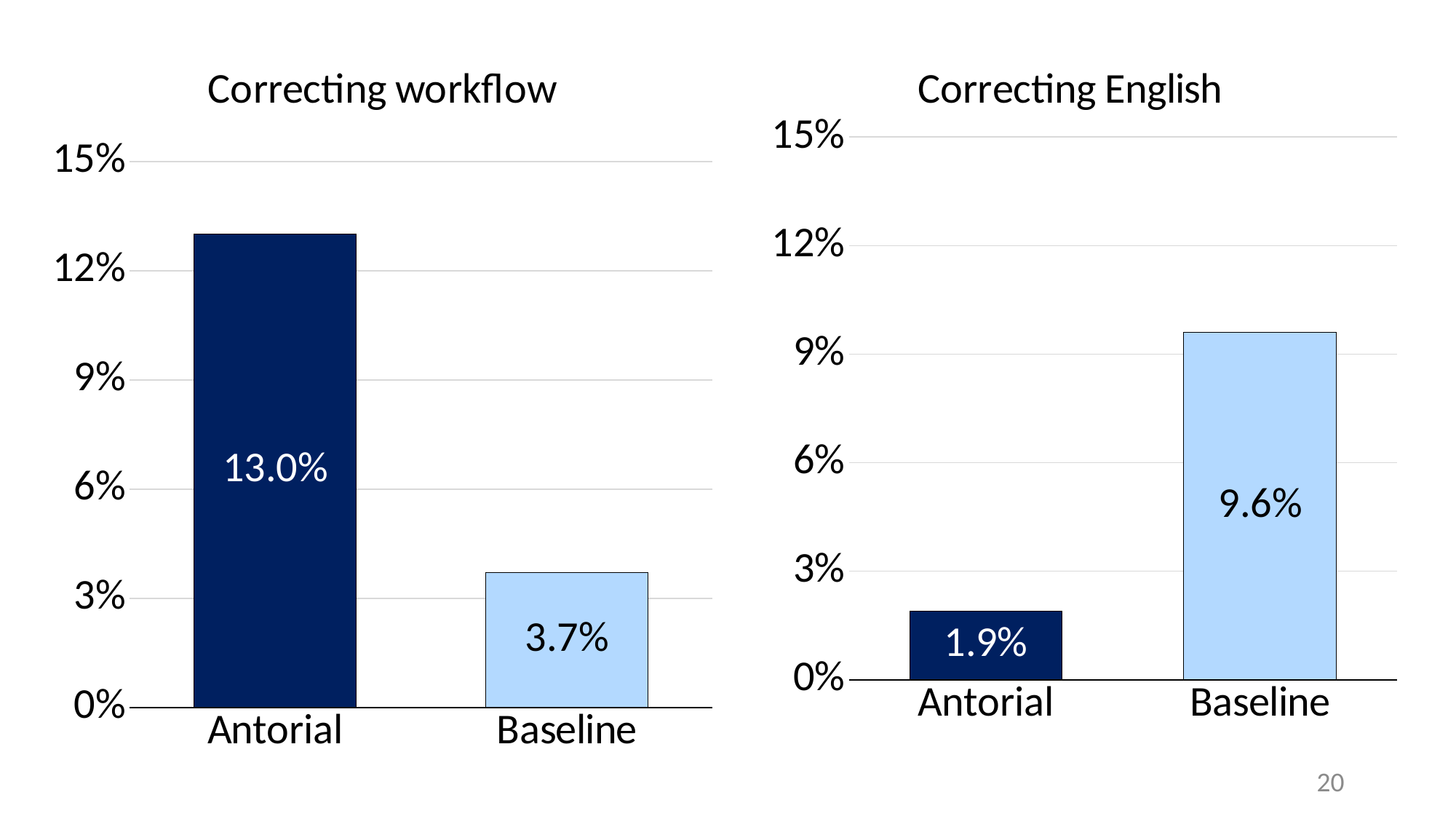
In the 'Correcting workflow' chart, what is the difference between the Antorial and Baseline values? 9.3% What type of chart is the 'Correcting workflow' chart? Bar chart How many categories are shown in the 'Correcting English' chart? 2 In the 'Correcting workflow' chart, what is the value for Baseline? 3.7% In the 'Correcting workflow' chart, is the value for Antorial greater or less than 12%? greater In the 'Correcting English' chart, which is larger, Antorial or Baseline? Baseline In the 'Correcting workflow' chart, which category has the highest value? Antorial In the 'Correcting English' chart, which category has the lowest value? Antorial In the 'Correcting English' chart, what is the value for Baseline? 9.6% In the 'Correcting workflow' chart, what is the value for Antorial? 13.0% In the 'Correcting English' chart, what is the difference between the Baseline and Antorial values? 7.7% In the 'Correcting English' chart, what is the value for Antorial? 1.9%